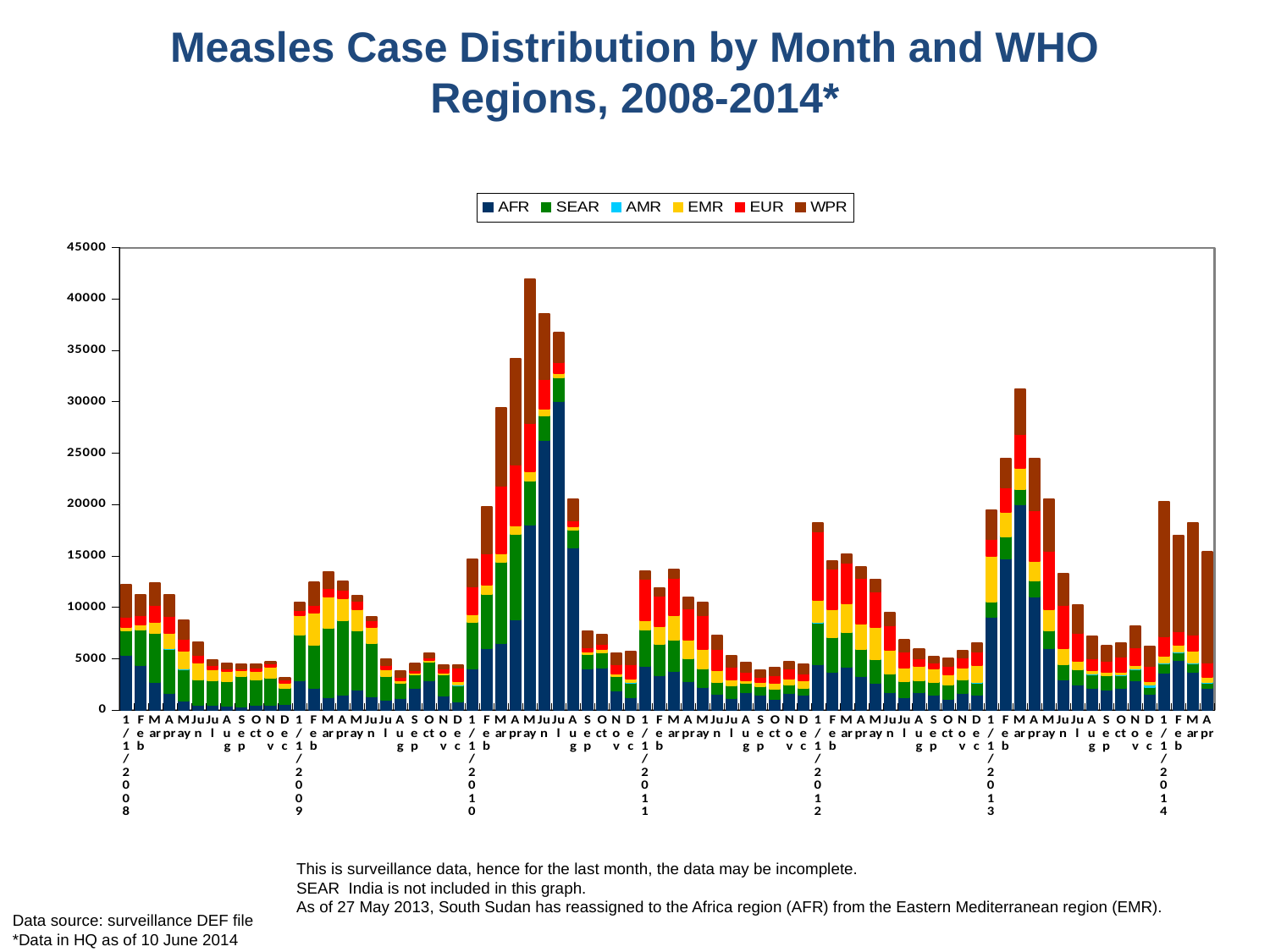
What is the title of the chart? Measles Case Distribution by Month and WHO Regions, 2008-2014* In which year does the tallest bar of the chart occur? 2010 How many series does the legend list? 6 Do the monthly totals rise or fall from January 2010 to the peak in mid-2010? rise Which is larger, the highest bar in 2010 or the highest bar in 2013? The highest bar in 2010 Is the value for the first bar (1/1/2008) greater or less than 15000? less What kind of chart is shown on the slide? Stacked bar chart Which WHO regions are listed in the legend? AFR, SEAR, AMR, EMR, EUR, WPR Is the highest bar in 2013 greater or less than 30000? greater Is the tallest bar on the chart greater or less than 40000? greater What is the highest value shown on the y axis? 45000